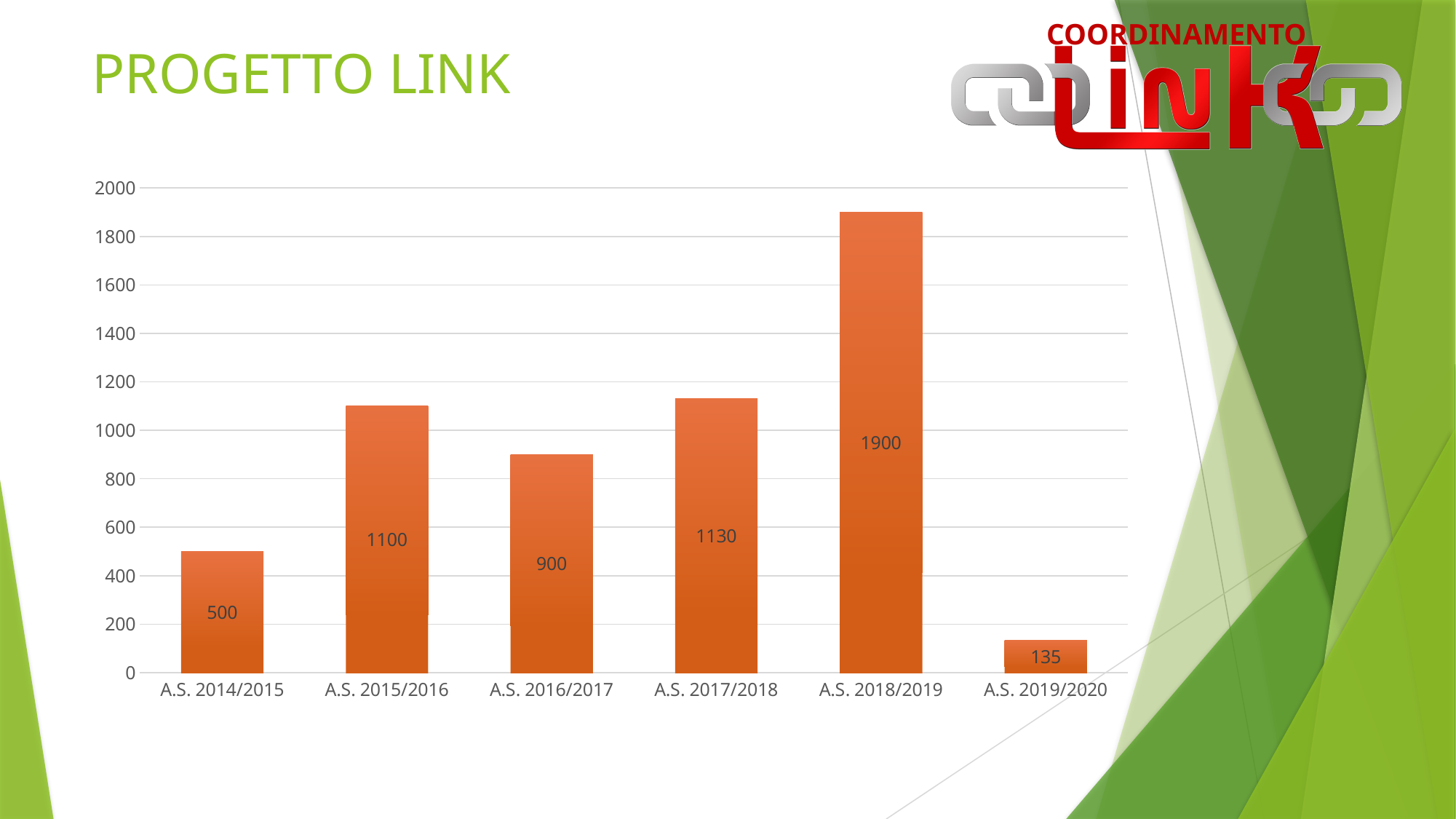
Is the value for A.S. 2018/2019 greater or less than 1800? greater What is the value for A.S. 2014/2015? 500 How many school years are shown on the x axis? 6 What is the value for A.S. 2019/2020? 135 What is the title of the slide? PROGETTO LINK What is the difference between the values for A.S. 2015/2016 and A.S. 2016/2017? 200 Which is larger, the value for A.S. 2015/2016 or A.S. 2016/2017? A.S. 2015/2016 Which school year has the highest value? A.S. 2018/2019 What kind of chart is shown on the slide? bar chart What is the difference between the values for A.S. 2018/2019 and A.S. 2017/2018? 770 Which school year has the lowest value? A.S. 2019/2020 What is the value for A.S. 2017/2018? 1130